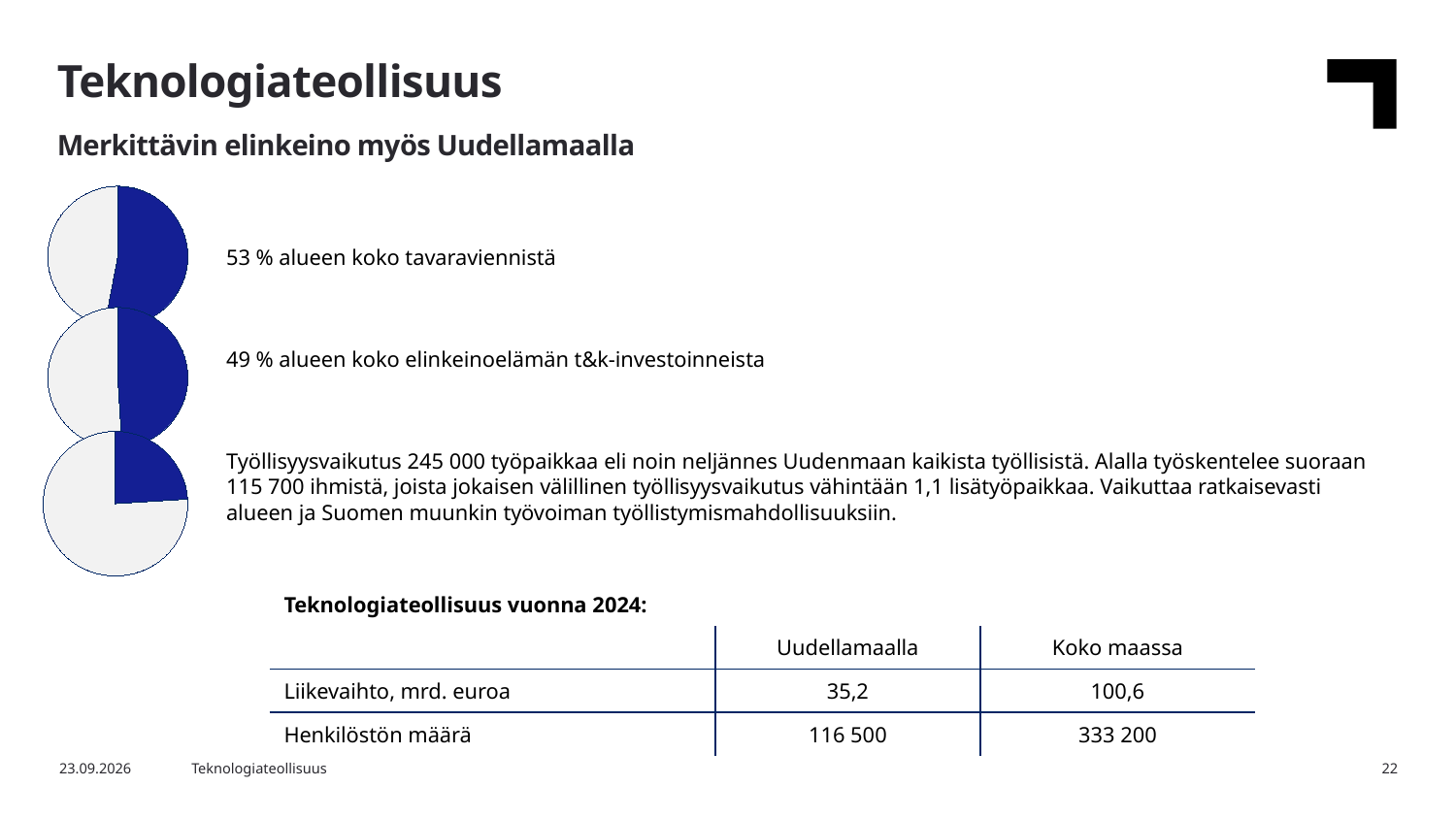
What is the difference in percentage points between the blue share of the top pie chart and the blue share of the middle pie chart? 4 percentage points How many pie charts are on the slide? 3 Which is larger, the blue share in the top pie chart (goods exports) or in the middle pie chart (R&D investments)? Top pie chart (goods exports) In the top pie chart, what share of the region's total goods exports (tavaravienti) does the blue slice represent? 53 % What kind of charts are shown on the left side of the slide? Pie charts What does the bottom pie chart illustrate, according to the text next to it? Employment impact: about a quarter of all employed people in Uusimaa How many slices does each pie chart have? 2 What colour is the highlighted slice in each pie chart? Blue Is the blue slice of the bottom pie chart greater or less than half of the pie? less In the middle pie chart, what share of the region's business R&D investments (t&k-investoinnit) does the blue slice represent? 49 % Which pie chart has the largest blue slice: the top, middle or bottom one? Top Which pie chart has the smallest blue slice: the top, middle or bottom one? Bottom